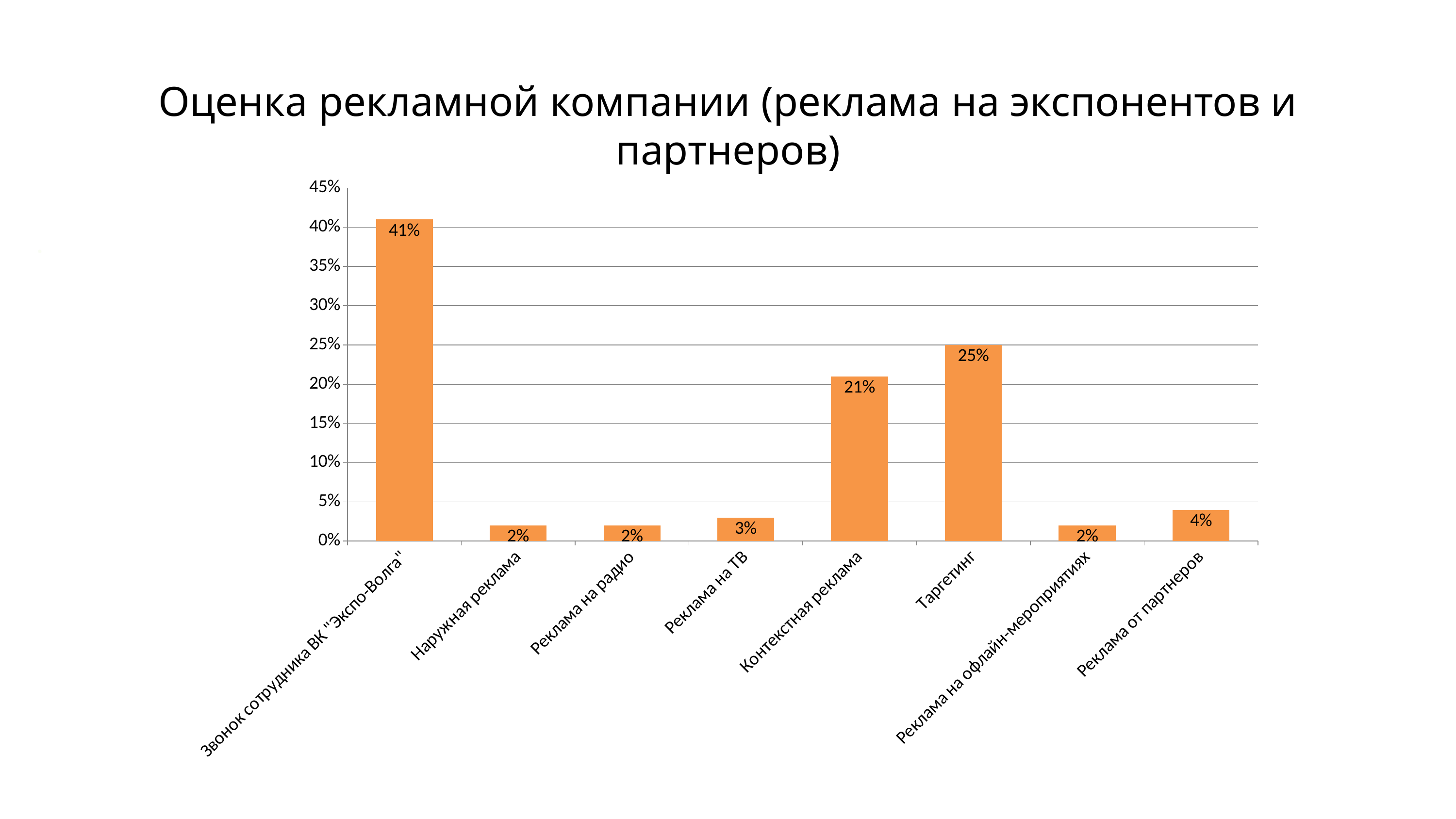
How many categories are shown on the x axis? 8 What is the value for Таргетинг? 25% What is the value for Контекстная реклама? 21% What is the difference between the values for Звонок сотрудника ВК "Экспо-Волга" and Таргетинг? 16% What is the difference between the values for Таргетинг and Контекстная реклама? 4% Which is larger, the value for Реклама от партнеров or the value for Реклама на ТВ? Реклама от партнеров What is the value for Реклама на ТВ? 3% What is the value for Реклама от партнеров? 4% What kind of chart is shown on the slide? bar chart Which category has the highest value? Звонок сотрудника ВК "Экспо-Волга" What is the title of the chart? Оценка рекламной компании (реклама на экспонентов и партнеров) Is the value for Контекстная реклама greater or less than 20%? greater